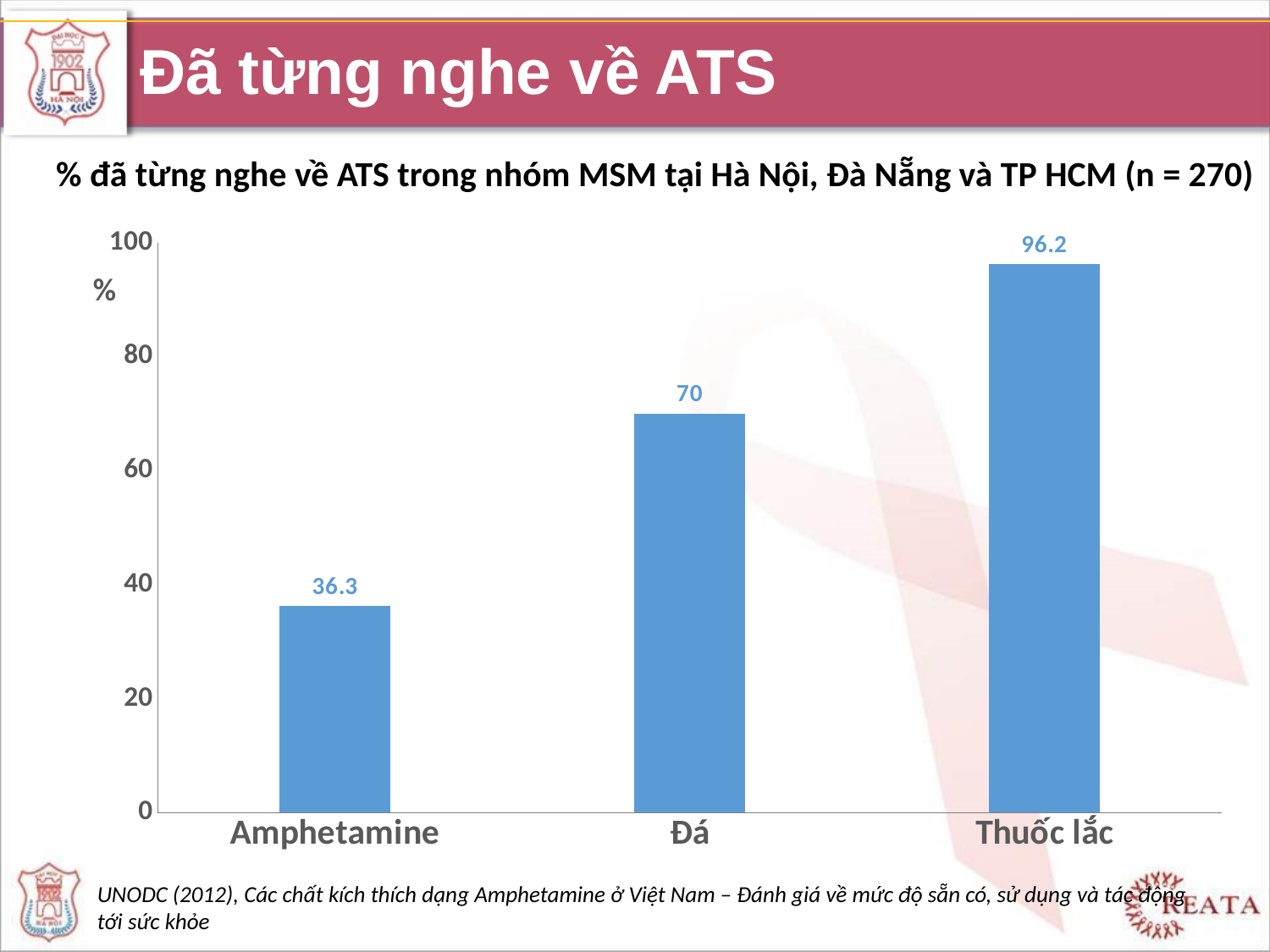
What is the value for Amphetamine? 36.3 What is the difference between the values for Đá and Amphetamine? 33.7 Is the value for Amphetamine greater or less than 40? less Which category has the lowest value? Amphetamine What is the title of the chart? % đã từng nghe về ATS trong nhóm MSM tại Hà Nội, Đà Nẵng và TP HCM (n = 270) How many categories are shown on the x axis? 3 Which is larger, the value for Amphetamine or the value for Đá? Đá What is the value for Thuốc lắc? 96.2 What kind of chart is shown on the slide? bar chart Which category has the highest value? Thuốc lắc What is the value for Đá? 70 What is the difference between the values for Thuốc lắc and Đá? 26.2